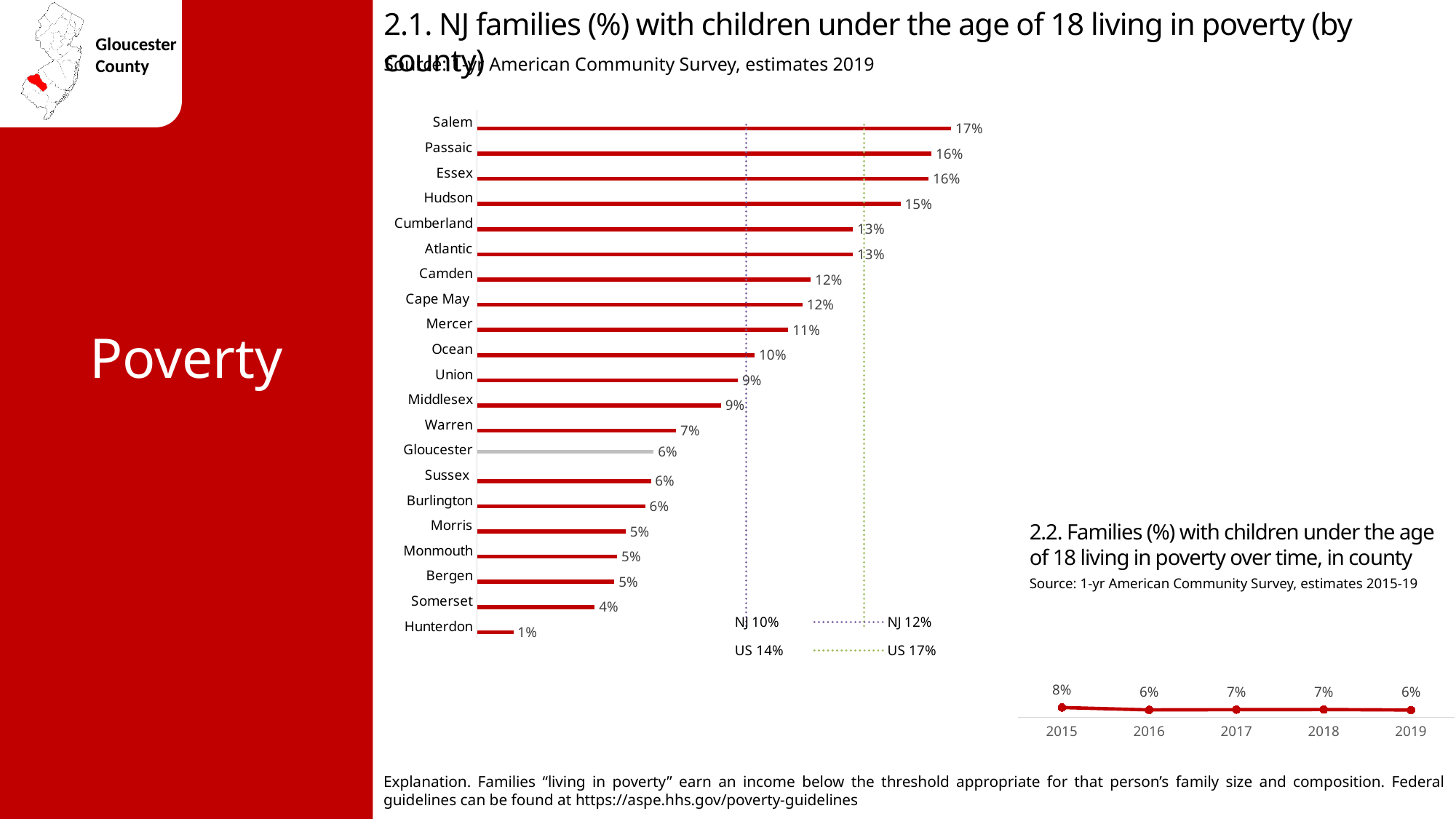
In chart 2.1, what is the difference between the values for Salem and Gloucester? 11% What kind of chart is chart 2.1? Bar chart In chart 2.1, which county has the highest value? Salem In chart 2.2, how many years are plotted? 5 In chart 2.2, what is the value for 2015? 8% In chart 2.2, what is the difference between the values for 2015 and 2019? 2% In chart 2.1, what is the value for Salem? 17% In chart 2.1, what is the value for Somerset? 4% In chart 2.1, what is the value for Gloucester? 6% In chart 2.1, which county has the lowest value? Hunterdon In chart 2.1, how many counties are shown? 21 In chart 2.1, which has a larger value, Hudson or Camden? Hudson